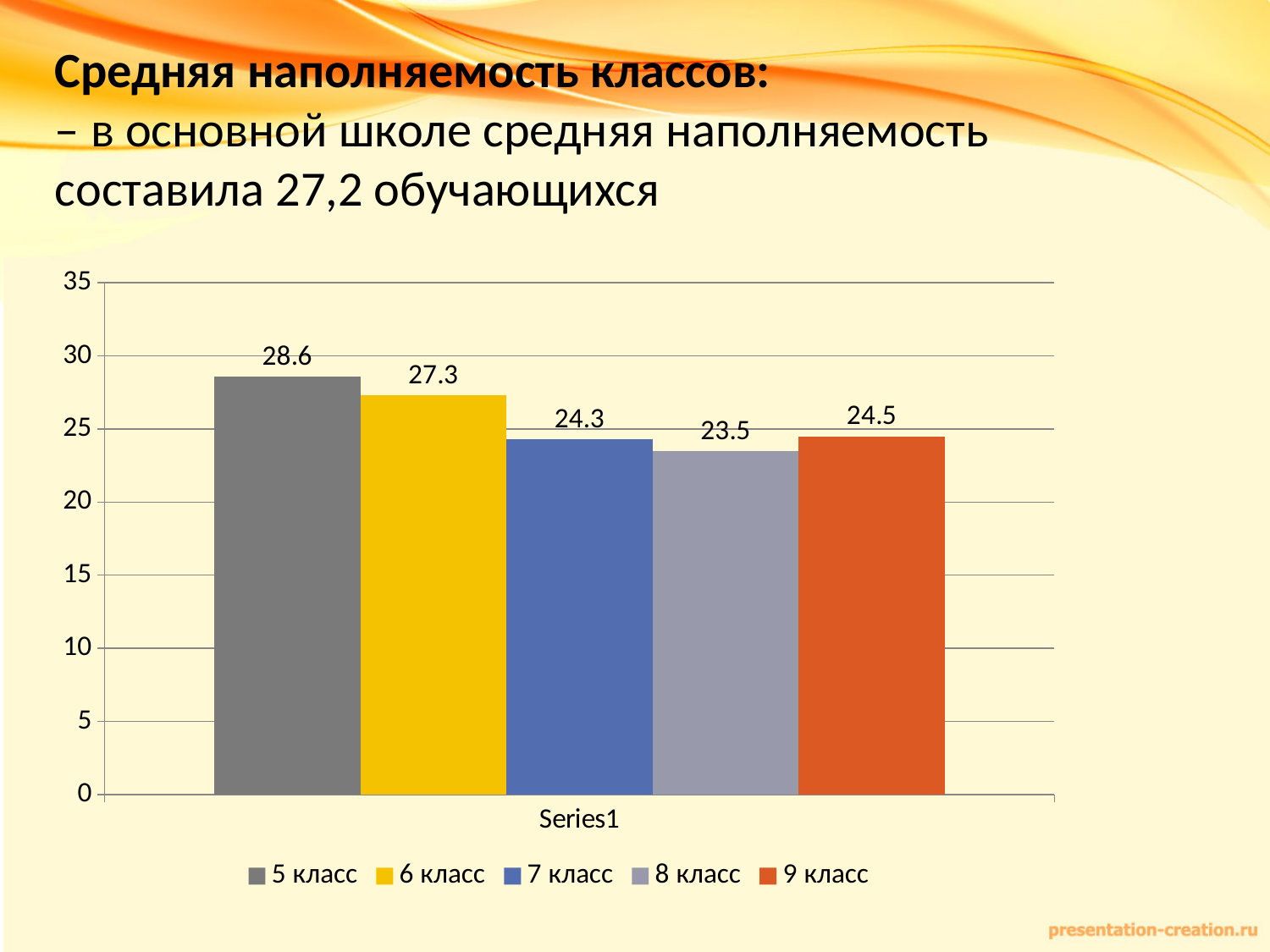
How many series does the legend list? 5 Is the value for 6 класс greater or less than 25? greater What is the value for 8 класс? 23.5 What is the value for 9 класс? 24.5 Which class has the highest value? 5 класс Which class has the lowest value? 8 класс What is the value for 5 класс? 28.6 What colour is the bar for 6 класс? yellow Which is larger, the value for 7 класс or 9 класс? 9 класс What is the difference between the values for 5 класс and 6 класс? 1.3 What is the difference between the values for 9 класс and 8 класс? 1 What kind of chart is shown on the slide? bar chart